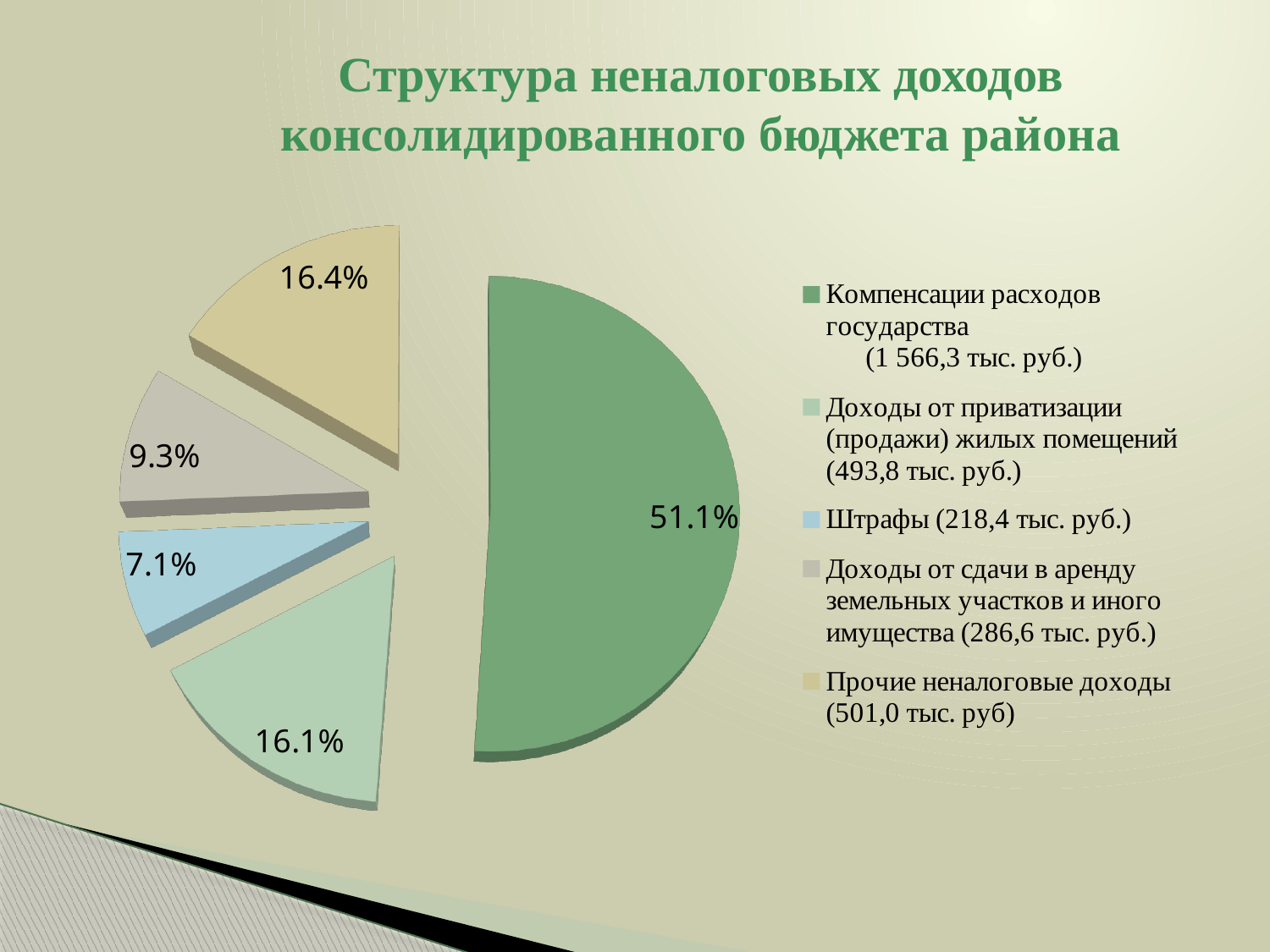
Which category has the smallest share of the pie? Штрафы What share of the pie does "Компенсации расходов государства" take? 51.1% What amount in thousand rubles does the legend give for "Штрафы"? 218,4 тыс. руб. How many slices does the pie chart have? 5 What percentage is shown for "Доходы от сдачи в аренду земельных участков и иного имущества"? 9.3% Which is larger: the share for "Штрафы" or the share for "Доходы от сдачи в аренду земельных участков и иного имущества"? Доходы от сдачи в аренду земельных участков и иного имущества What kind of chart is shown on the slide? Pie chart Which category has the largest share of the pie? Компенсации расходов государства What is the difference in percentage points between "Компенсации расходов государства" and "Прочие неналоговые доходы"? 34.7 What percentage is shown for "Прочие неналоговые доходы"? 16.4% What percentage is shown for "Штрафы"? 7.1% What percentage is shown for "Доходы от приватизации (продажи) жилых помещений"? 16.1%